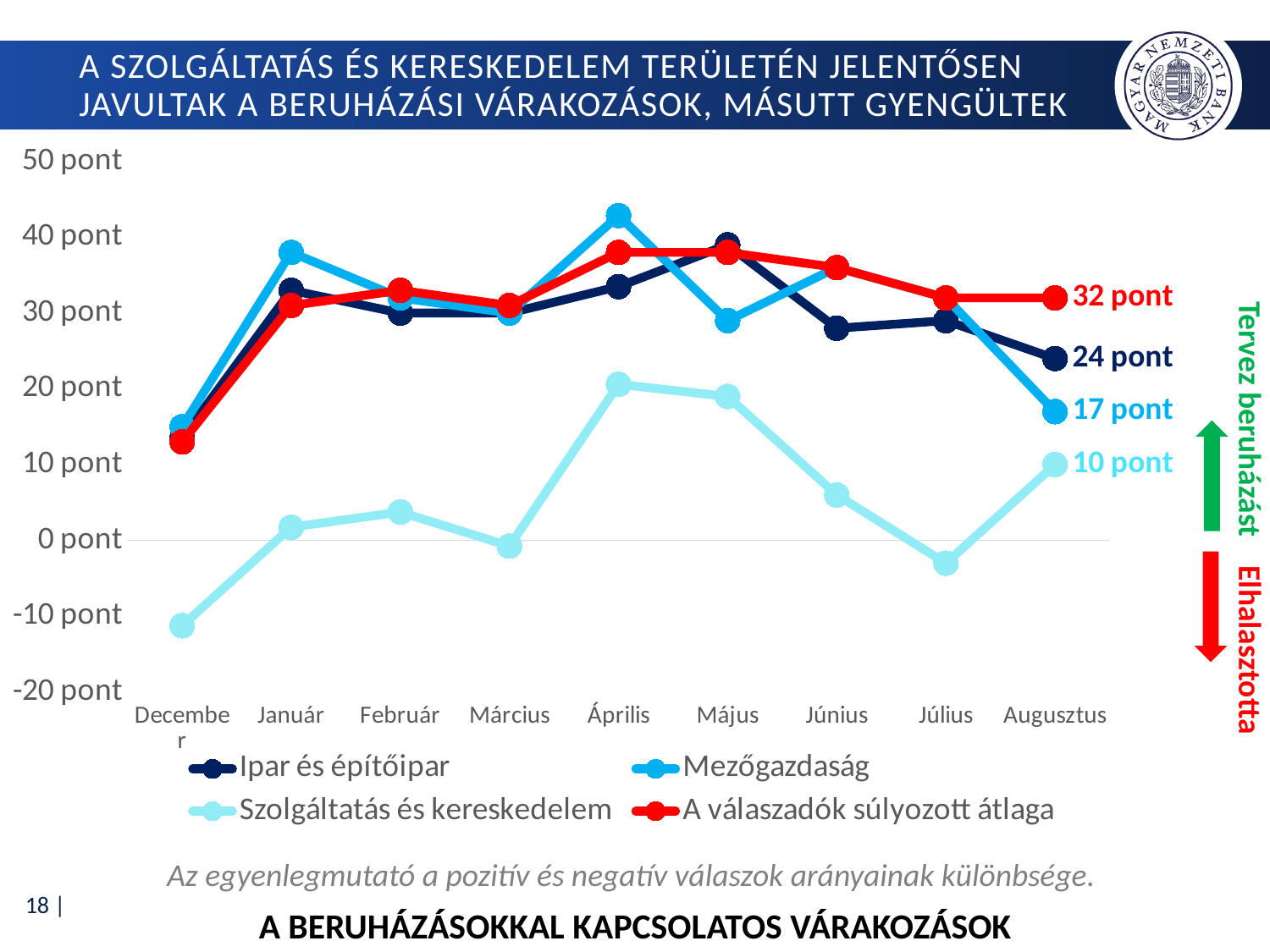
What kind of chart is shown on the slide? line chart In which month does 'Szolgáltatás és kereskedelem' reach its lowest value? December Is the value for 'Szolgáltatás és kereskedelem' in December greater or less than 0 pont? less What is the value of 'Mezőgazdaság' in Augusztus? 17 pont How many months are shown on the x axis? 9 Which series has the highest value in Augusztus? A válaszadók súlyozott átlaga In Augusztus, what is the difference between 'A válaszadók súlyozott átlaga' and 'Szolgáltatás és kereskedelem'? 22 pont What is the value of 'Szolgáltatás és kereskedelem' in Augusztus? 10 pont How many series does the legend list? 4 What is the value of 'Ipar és építőipar' in Augusztus? 24 pont What is the value of 'A válaszadók súlyozott átlaga' in Augusztus? 32 pont In Augusztus, which is larger: 'Ipar és építőipar' or 'Mezőgazdaság'? Ipar és építőipar